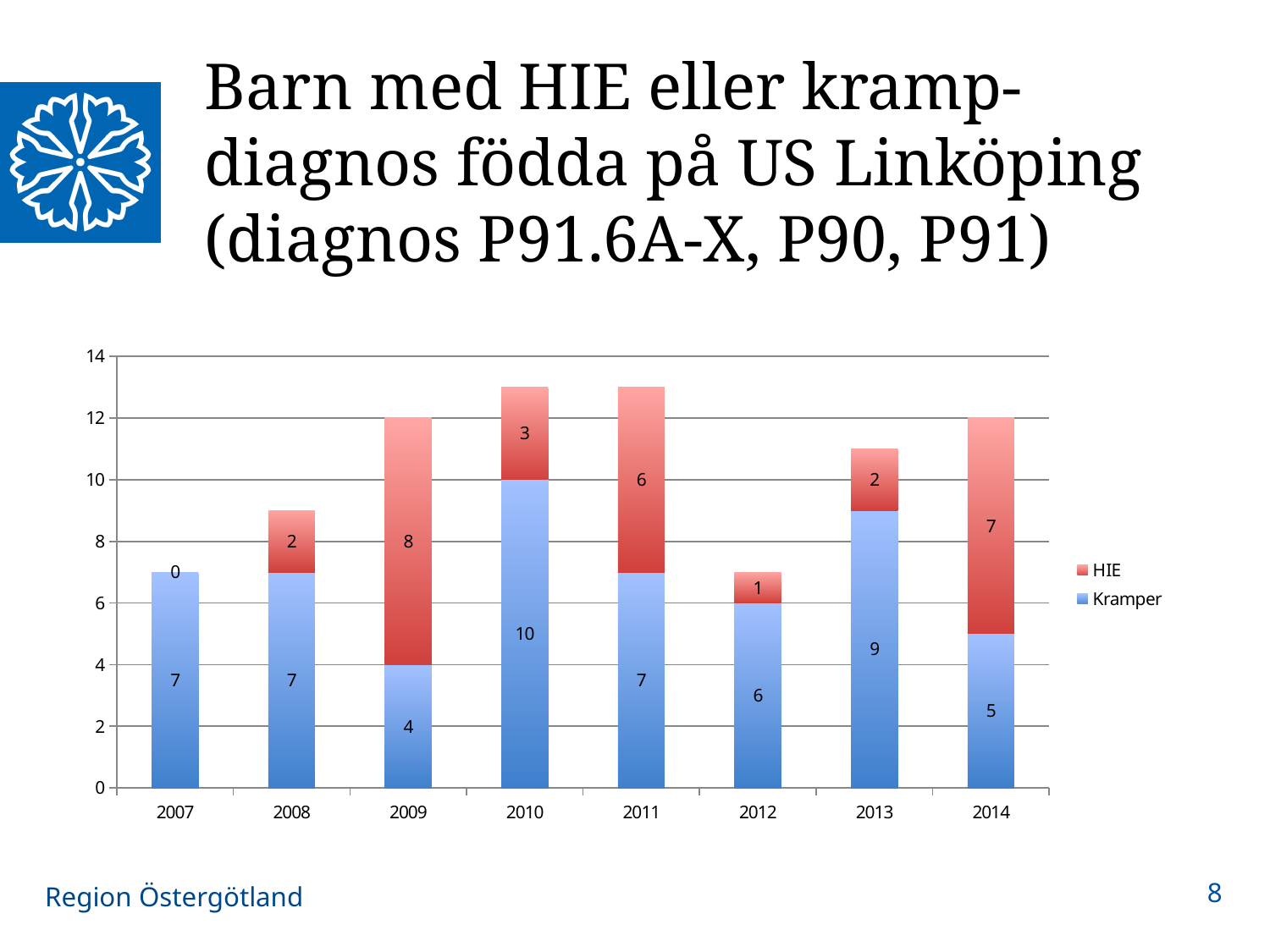
What is the HIE value for 2014? 7 What is the Kramper value for 2010? 10 What is the difference between the Kramper value in 2013 and the Kramper value in 2014? 4 What is the total of the stacked bar for 2013? 11 Which year has the lowest HIE value? 2007 How many series does the legend list? 2 What is the HIE value for 2009? 8 Which year has the highest Kramper value? 2010 How many years are shown on the x axis? 8 Which year has the highest HIE value? 2009 What is the total of the stacked bar for 2009? 12 Which is larger, the HIE value for 2011 or the HIE value for 2013? 2011